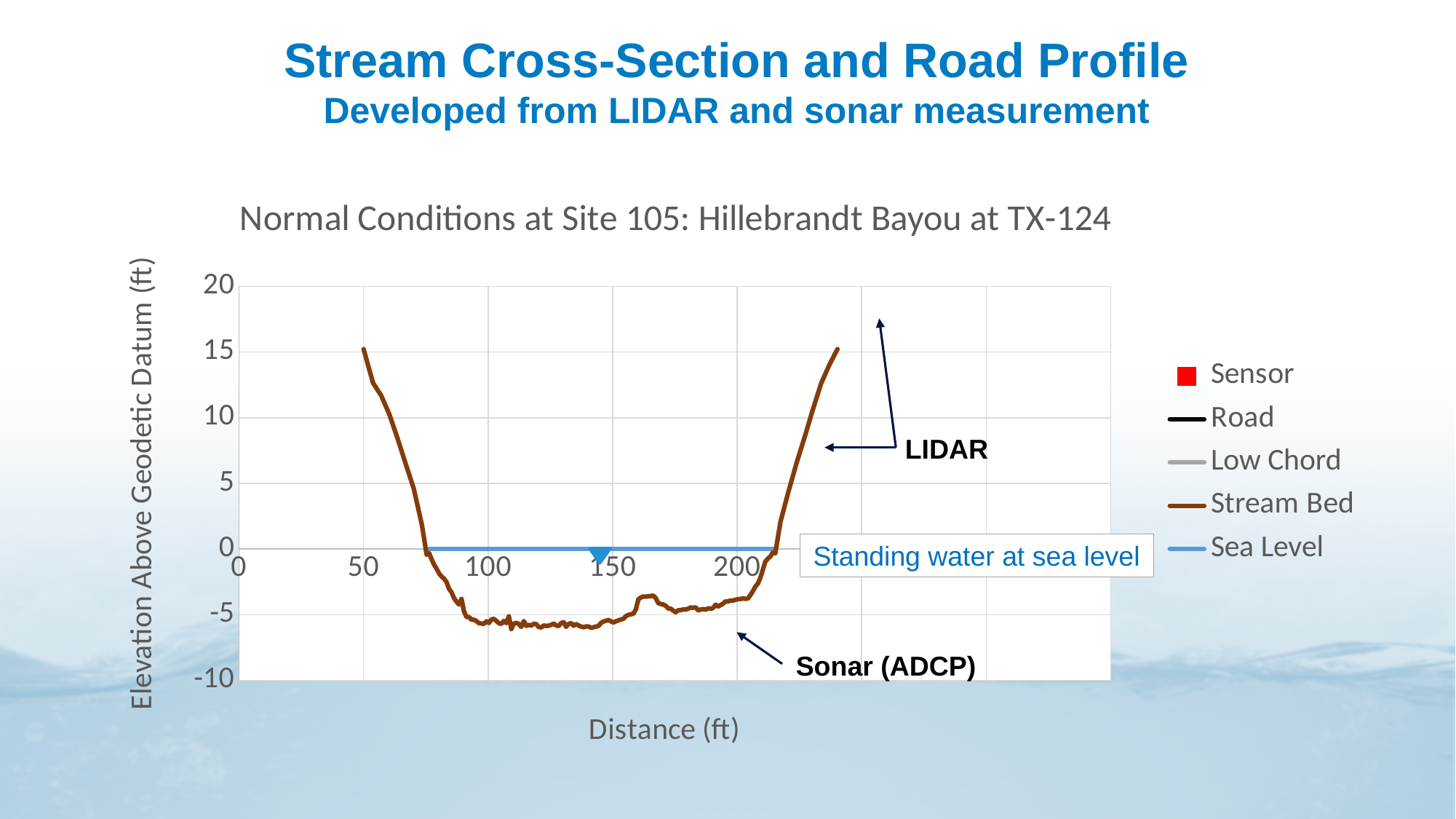
How many series does the legend list? 5 What is the title of the chart? Normal Conditions at Site 105: Hillebrandt Bayou at TX-124 What is the label of the vertical axis? Elevation Above Geodetic Datum (ft) At what elevation is the Sea Level line plotted? 0 Is the lowest Stream Bed elevation greater or less than -5? less Does the Stream Bed elevation rise or fall as distance increases from 200 ft to 240 ft? rise Is the Stream Bed elevation at a distance of 50 ft greater or less than 10? greater Does the Stream Bed elevation rise or fall as distance increases from 50 ft to 100 ft? fall What kind of chart is shown on the slide? line chart Which is higher: the Stream Bed elevation at 50 ft or at 150 ft? 50 ft Is the Stream Bed elevation at a distance of 100 ft greater or less than 0? less